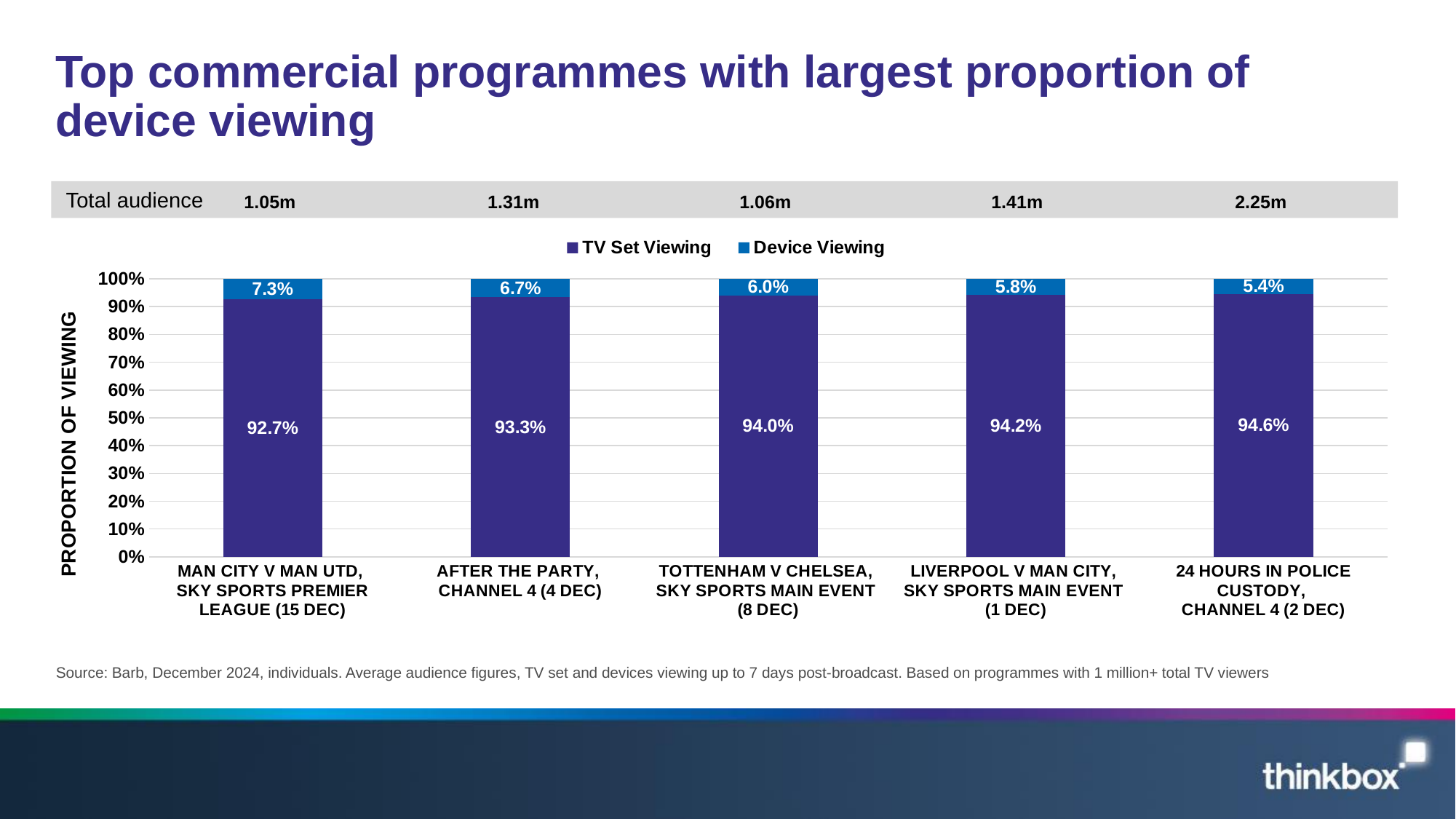
What is the TV Set Viewing share for 24 Hours in Police Custody, Channel 4 (2 Dec)? 94.6% What is the Device Viewing share for Man City v Man Utd, Sky Sports Premier League (15 Dec)? 7.3% Which programme has the lowest Device Viewing share? 24 Hours in Police Custody, Channel 4 (2 Dec) Which has a larger TV Set Viewing share: After the Party, Channel 4 (4 Dec) or Liverpool v Man City, Sky Sports Main Event (1 Dec)? Liverpool v Man City, Sky Sports Main Event (1 Dec) What is the total audience shown for Liverpool v Man City, Sky Sports Main Event (1 Dec)? 1.41m Does the Device Viewing share rise or fall moving from left to right across the programmes? Fall Which programme has the highest Device Viewing share? Man City v Man Utd, Sky Sports Premier League (15 Dec) How many programmes are shown on the chart? 5 How many series does the legend list? 2 What is the TV Set Viewing share for Tottenham v Chelsea, Sky Sports Main Event (8 Dec)? 94.0% What kind of chart is shown on the slide? Stacked bar chart What is the difference in Device Viewing share between Man City v Man Utd (15 Dec) and Liverpool v Man City (1 Dec)? 1.5%